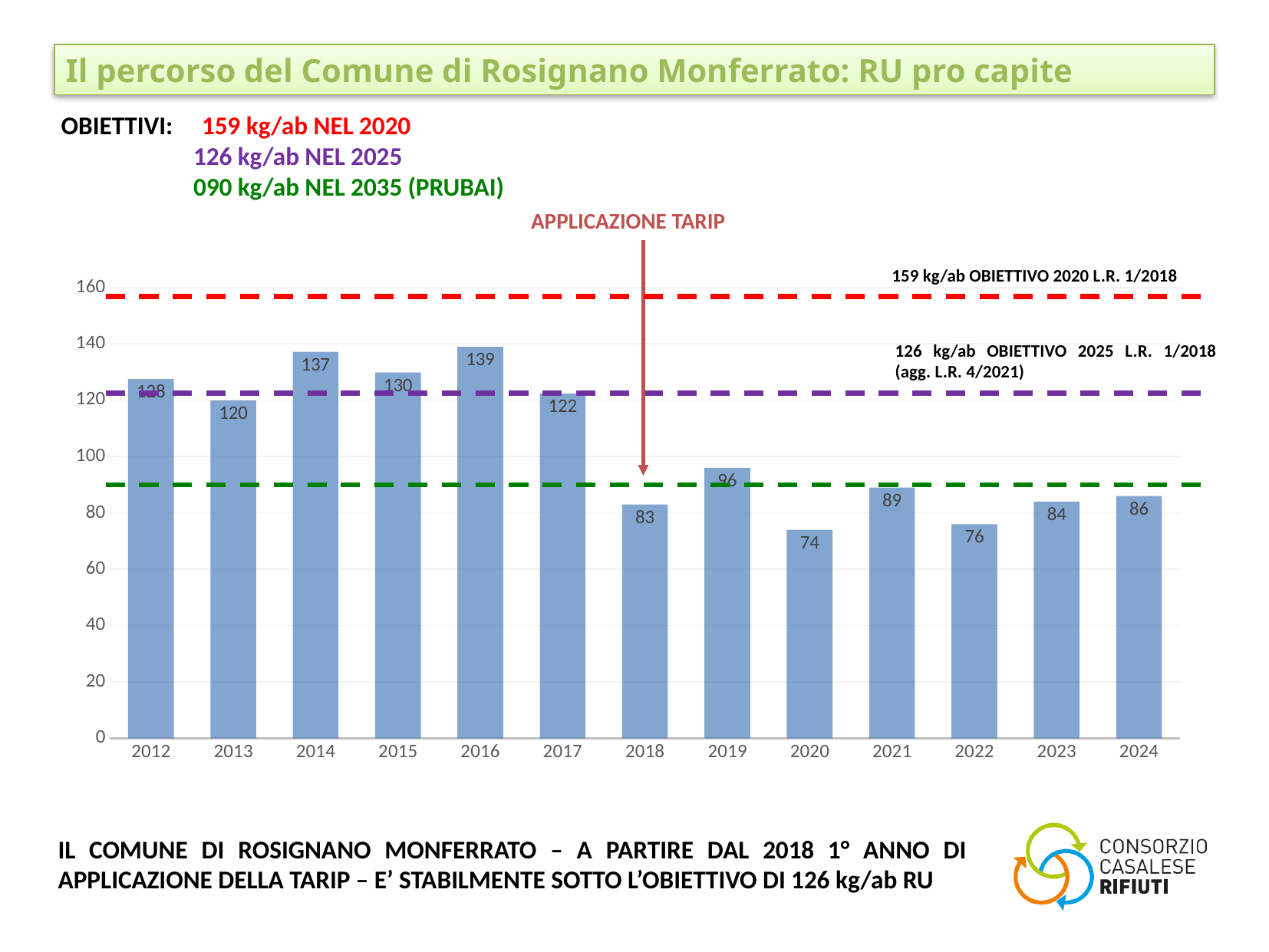
Which year has the larger value, 2014 or 2015? 2014 How many years are shown on the x axis? 13 Which year has the highest value? 2016 What does the red dashed line on the chart represent? 159 kg/ab OBIETTIVO 2020 L.R. 1/2018 What is the difference between the values for 2017 and 2018? 39 What kind of chart is shown on the slide? bar chart What is the value for 2023? 84 What is the value for 2020? 74 Is the value for 2012 greater or less than 120? greater What is the value for 2018? 83 Which year has the lowest value? 2020 What is the value for 2016? 139